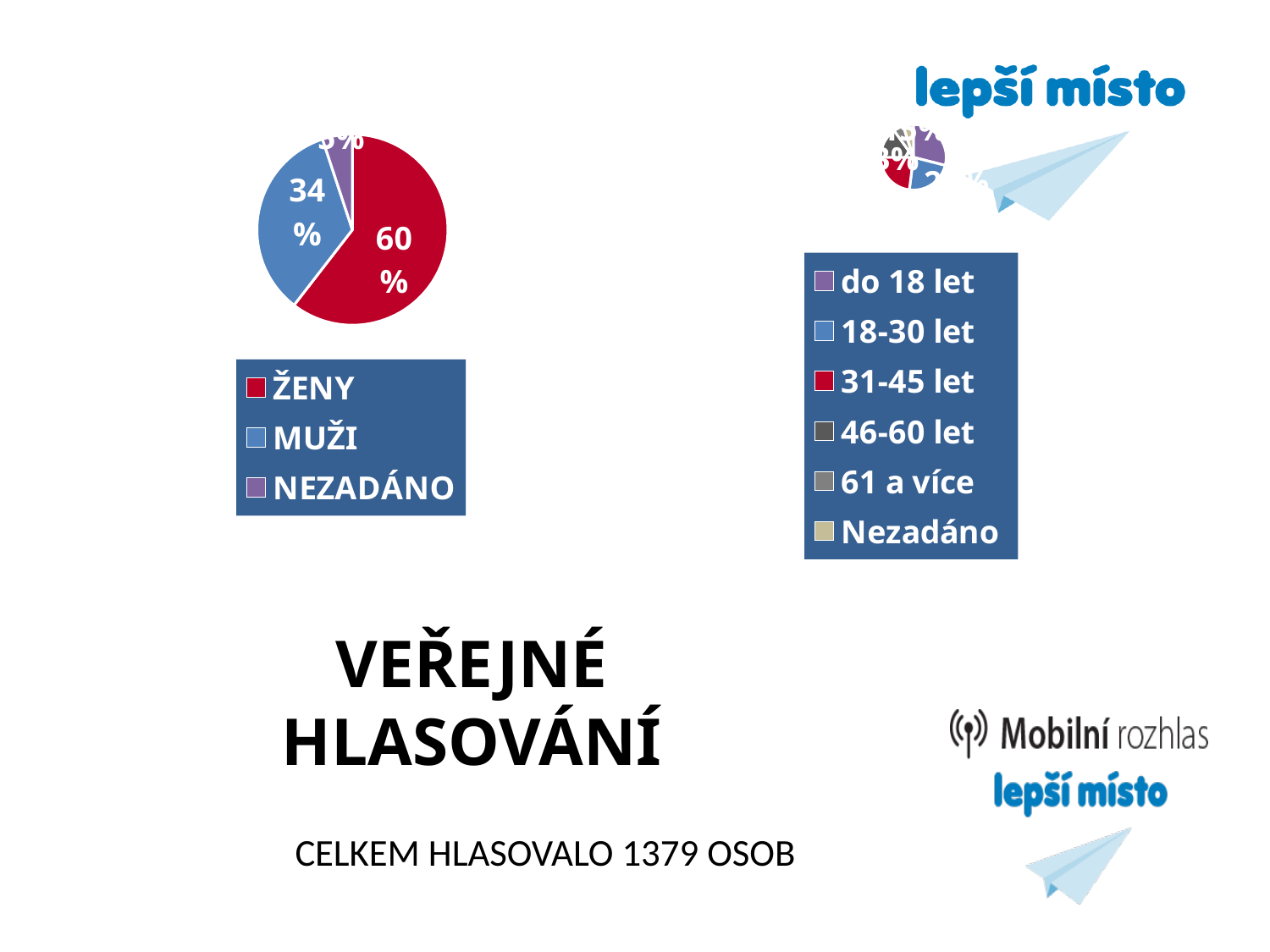
What kind of chart is the right chart on the slide? Pie chart On the left pie chart, by how many percentage points does ŽENY exceed MUŽI? 26 percentage points On the left pie chart, which is larger: the share for ŽENY or the share for MUŽI? ŽENY What is the first legend entry of the right chart (age groups)? do 18 let On the left pie chart, what percentage is shown for ŽENY? 60% On the left pie chart, which colour represents ŽENY? Red What kind of chart is the left chart on the slide? Pie chart How many categories does the legend of the right chart (age groups) list? 6 On the left pie chart, what percentage is shown for MUŽI? 34% On the left pie chart, which category has the largest slice? ŽENY On the left pie chart, which category has the smallest slice? NEZADÁNO How many categories does the left pie chart's legend list? 3